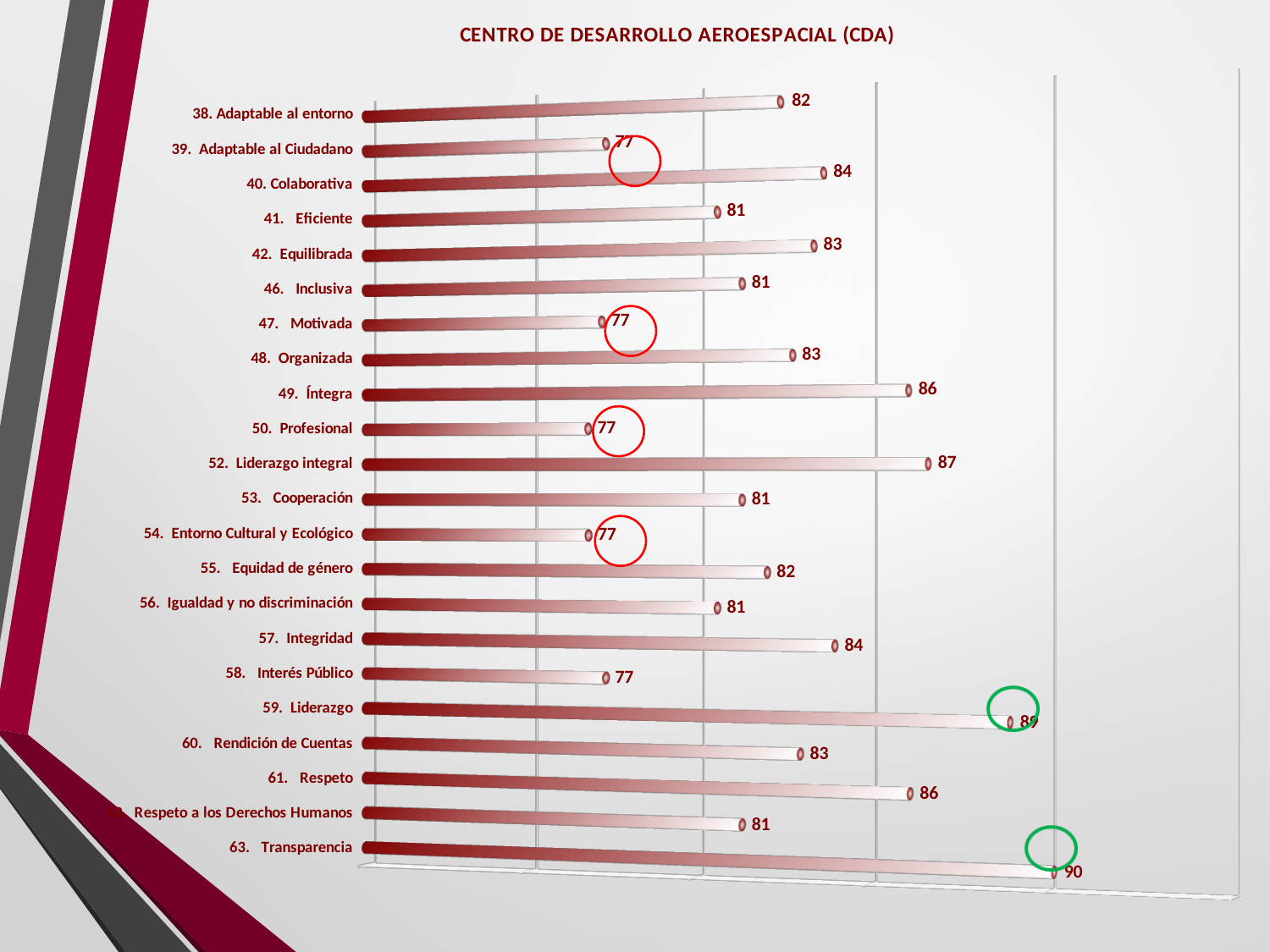
Which category has the highest value? 63. Transparencia What is the value for 63. Transparencia? 90 Which has a larger value, 49. Íntegra or 42. Equilibrada? 49. Íntegra What is the difference between the values for 61. Respeto and 41. Eficiente? 5 What is the value for 47. Motivada? 77 What is the value for 52. Liderazgo integral? 87 What is the difference between the values for 63. Transparencia and 58. Interés Público? 13 What kind of chart is shown on the slide? Bar chart How many categories are plotted in the chart? 22 What is the lowest value shown in the chart? 77 What is the title of the chart? CENTRO DE DESARROLLO AEROESPACIAL (CDA) What is the value for 40. Colaborativa? 84